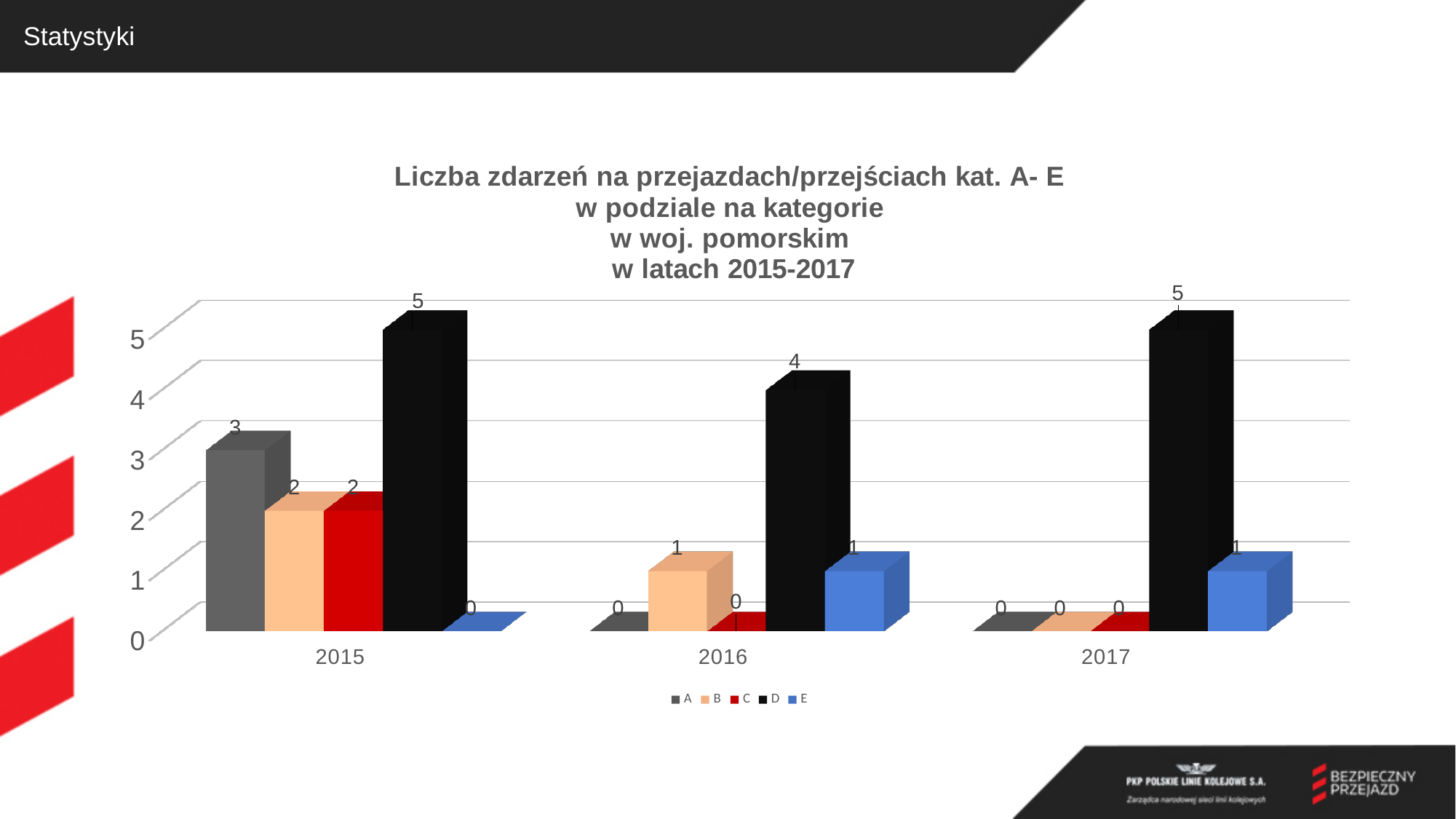
Does the value for series A rise or fall from 2015 to 2017? fall What is the value for series E in 2017? 1 What is the value for series A in 2015? 3 What colour are the bars for series D? black Which series has the highest value in 2016? D What is the difference between series D and series A in 2015? 2 Which is larger in 2016: series B or series D? D What is the value for series B in 2016? 1 What is the value for series D in 2015? 5 What kind of chart is shown on the slide? bar chart How many years are shown on the x axis? 3 How many series does the legend list? 5